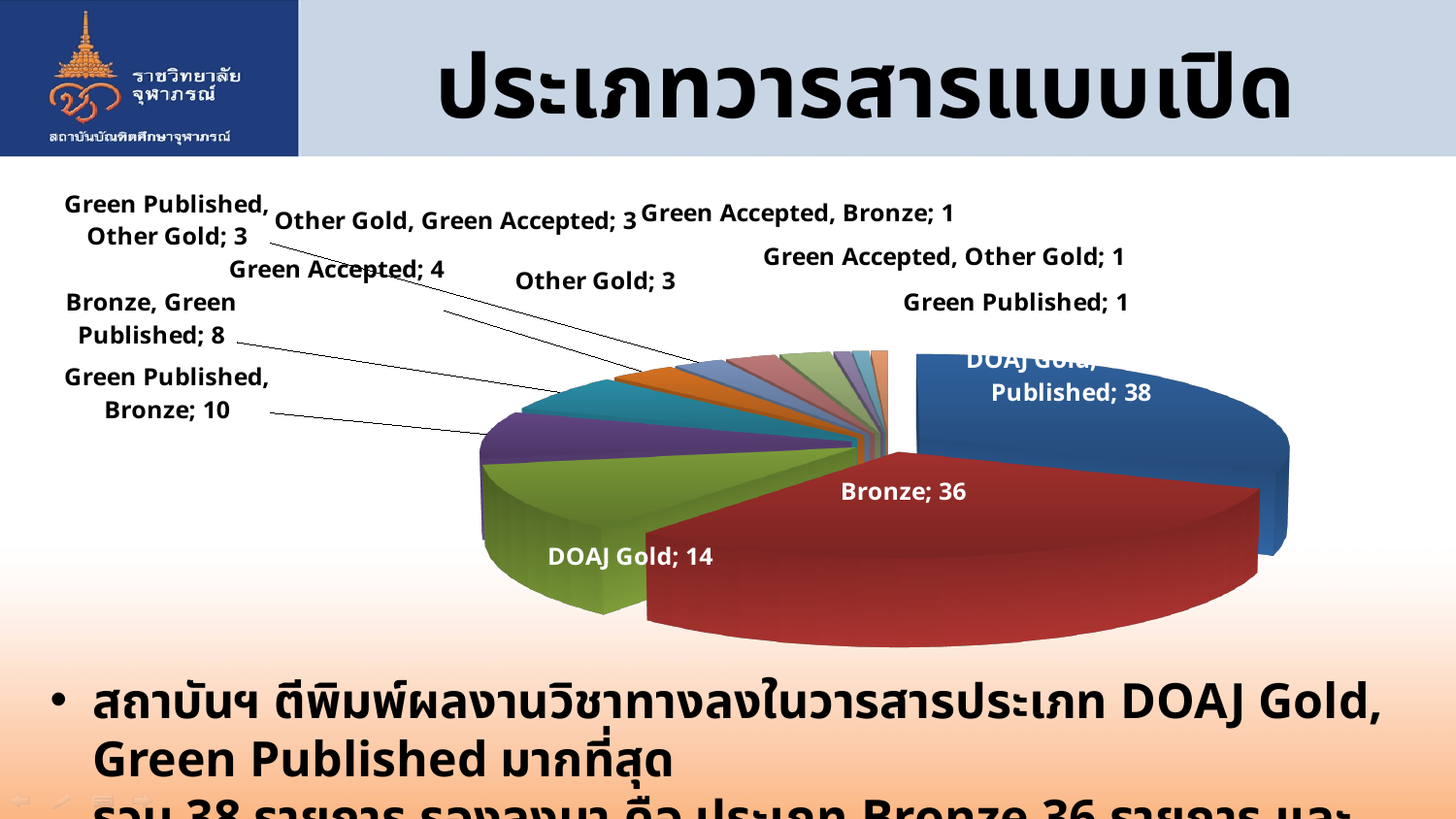
Which category has the largest slice in the pie chart? DOAJ Gold, Green Published Which is larger: Green Published, Bronze or Bronze, Green Published? Green Published, Bronze What kind of chart is shown on the slide? pie chart What is the difference between the DOAJ Gold, Green Published value and the Bronze value? 2 How many slices in the pie chart have a value of 1? 3 What is the difference between the Bronze value and the DOAJ Gold value? 22 How many slices does the pie chart have? 12 What is the value for the Green Accepted slice? 4 What is the value for the Green Published, Bronze slice? 10 What is the value for the Bronze slice? 36 What is the value for the Bronze, Green Published slice? 8 What is the value for the DOAJ Gold slice? 14